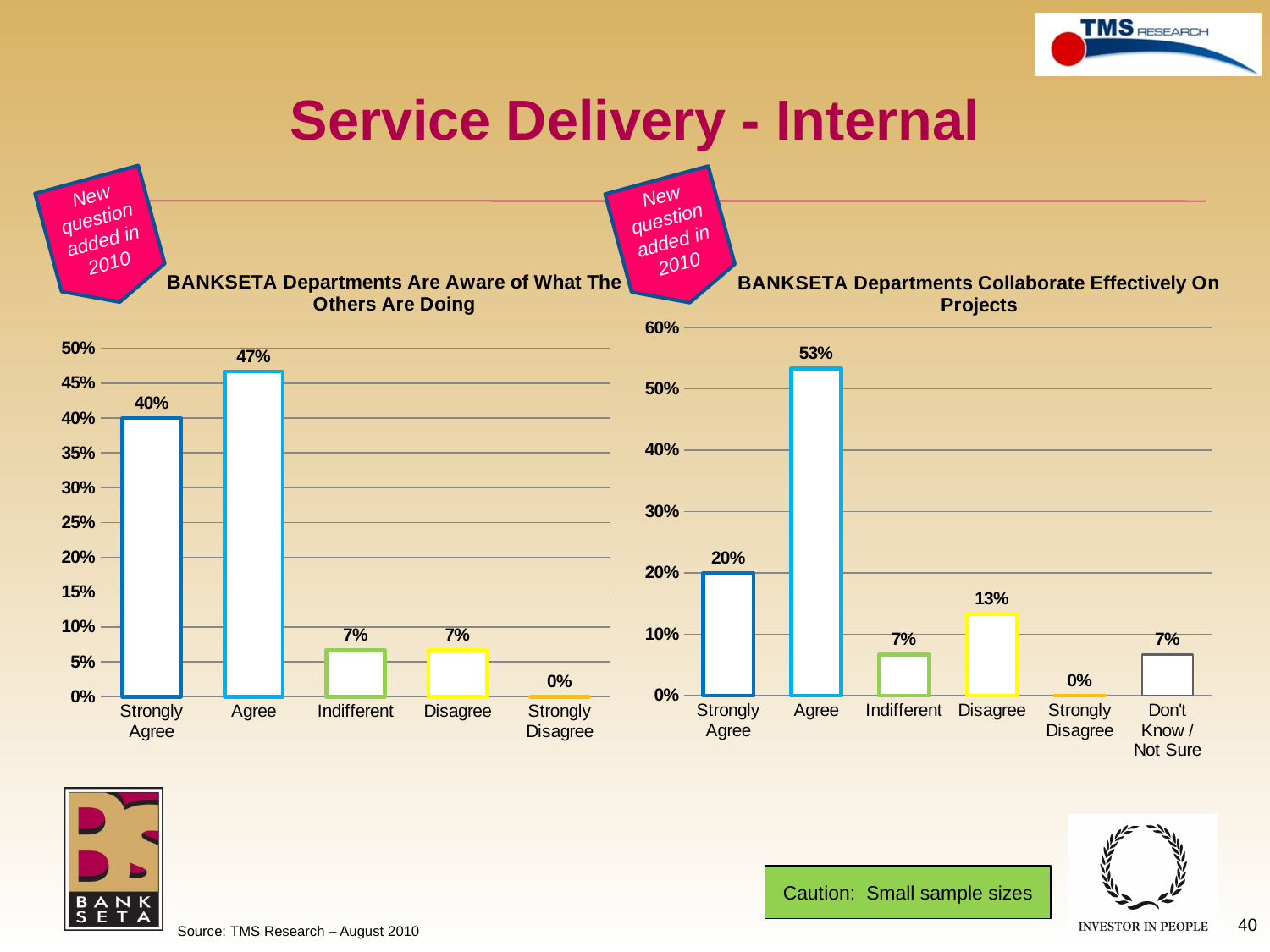
How many categories are shown in the chart titled 'BANKSETA Departments Are Aware of What The Others Are Doing'? 5 In the chart titled 'BANKSETA Departments Collaborate Effectively On Projects', what is the difference between Agree and Strongly Agree? 33% In the chart titled 'BANKSETA Departments Collaborate Effectively On Projects', what is the value for Don't Know / Not Sure? 7% Which is larger: Strongly Agree in the left chart or Strongly Agree in the right chart? Strongly Agree in the left chart In the chart titled 'BANKSETA Departments Collaborate Effectively On Projects', is the value for Agree greater or less than 50%? greater How many categories are shown in the chart titled 'BANKSETA Departments Collaborate Effectively On Projects'? 6 In the chart titled 'BANKSETA Departments Collaborate Effectively On Projects', which category has the lowest value? Strongly Disagree In the chart titled 'BANKSETA Departments Are Aware of What The Others Are Doing', which category has the highest value? Agree In the chart titled 'BANKSETA Departments Are Aware of What The Others Are Doing', what is the value for Agree? 47% In the chart titled 'BANKSETA Departments Are Aware of What The Others Are Doing', what is the difference between Agree and Strongly Agree? 7% What type of chart is the chart titled 'BANKSETA Departments Are Aware of What The Others Are Doing'? Bar chart In the chart titled 'BANKSETA Departments Collaborate Effectively On Projects', what is the value for Disagree? 13%